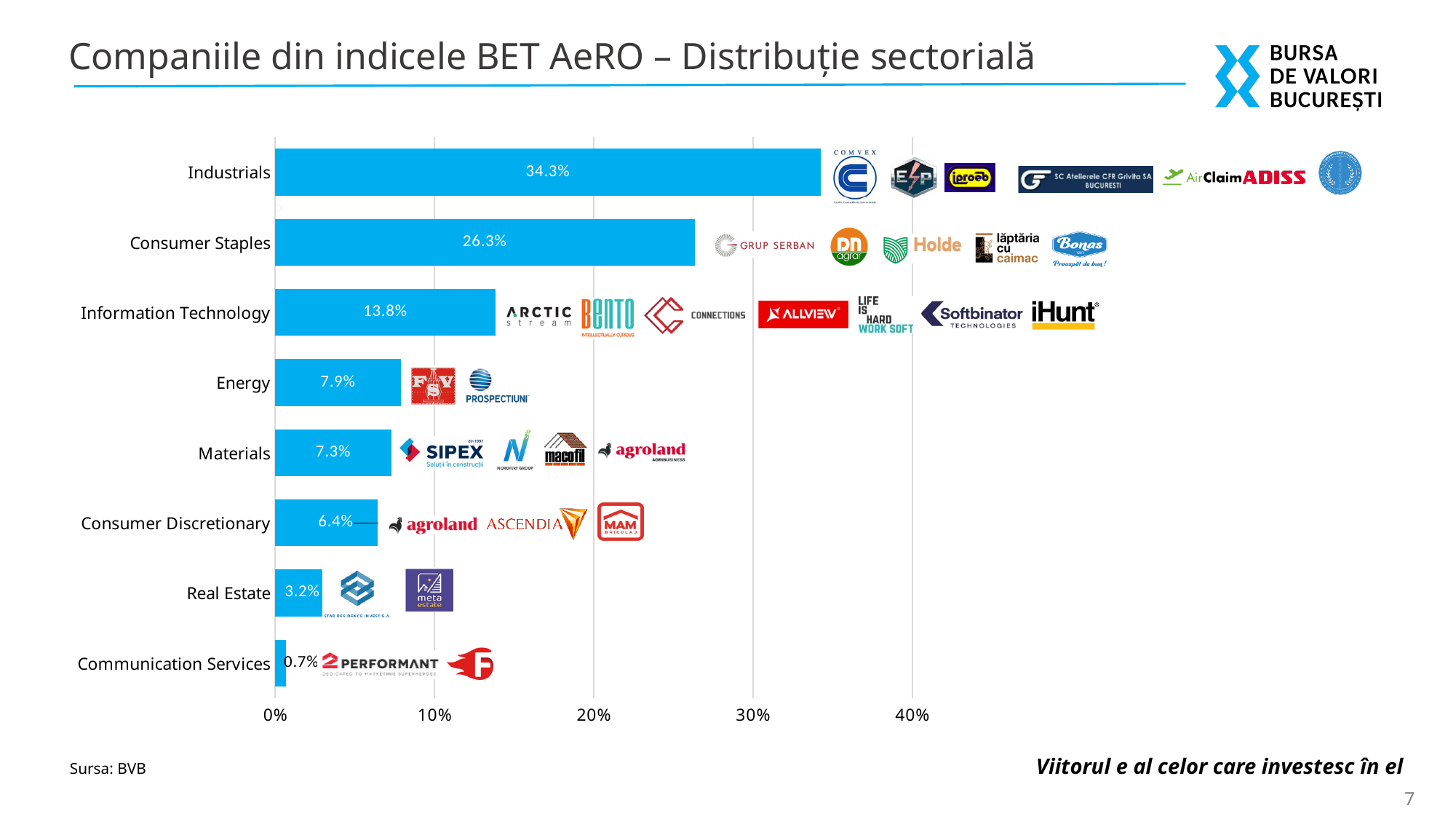
Which is larger, Energy or Materials? Energy What is the value for Information Technology? 13.8% Which sector has the lowest share? Communication Services What is the value for Industrials? 34.3% What is the value for Real Estate? 3.2% How many sectors are shown in the chart? 8 What kind of chart is shown on the slide? Bar chart Which sector has the highest share? Industrials What is the difference between Industrials and Consumer Staples? 8.0% Is the value for Consumer Staples greater or less than 20%? greater What is the value for Consumer Discretionary? 6.4% What is the source cited for the chart? BVB